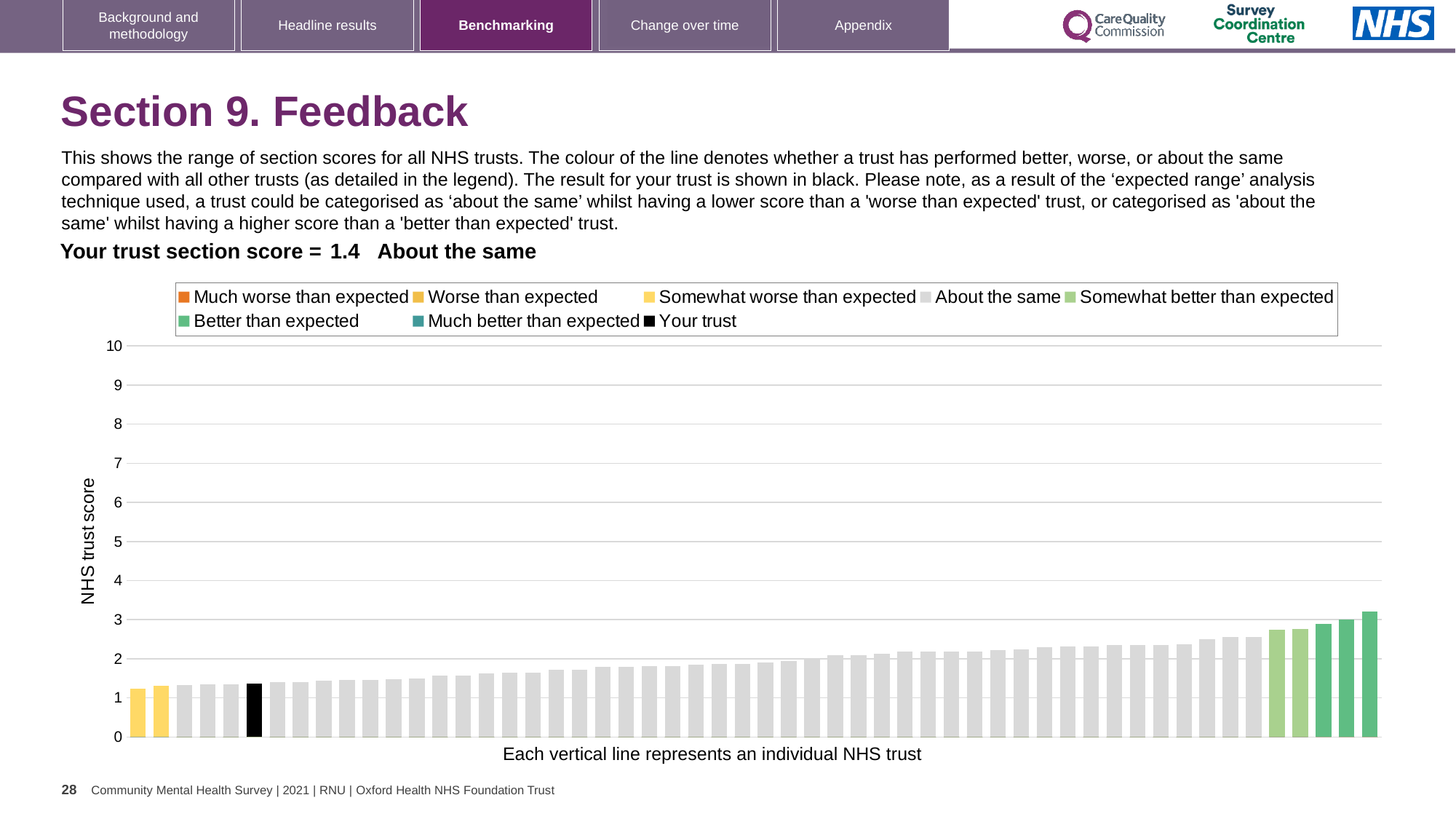
How many bars are shown in the 'Somewhat worse than expected' colour? 2 Is the value of the shortest bar greater or less than 2? less What is the section score for your trust? 1.4 What is the label on the y axis? NHS trust score What kind of chart is shown on the slide? bar chart Is the value of the tallest bar greater or less than 4? less Do the bar values rise or fall from left to right along the x axis? rise Is your trust's bar higher or lower than the tallest bar on the chart? lower Which category is your trust's section score placed in? About the same How many entries does the chart legend list? 8 What colour is used for the 'Your trust' bar? black Is the value of the tallest bar greater or less than 3? greater